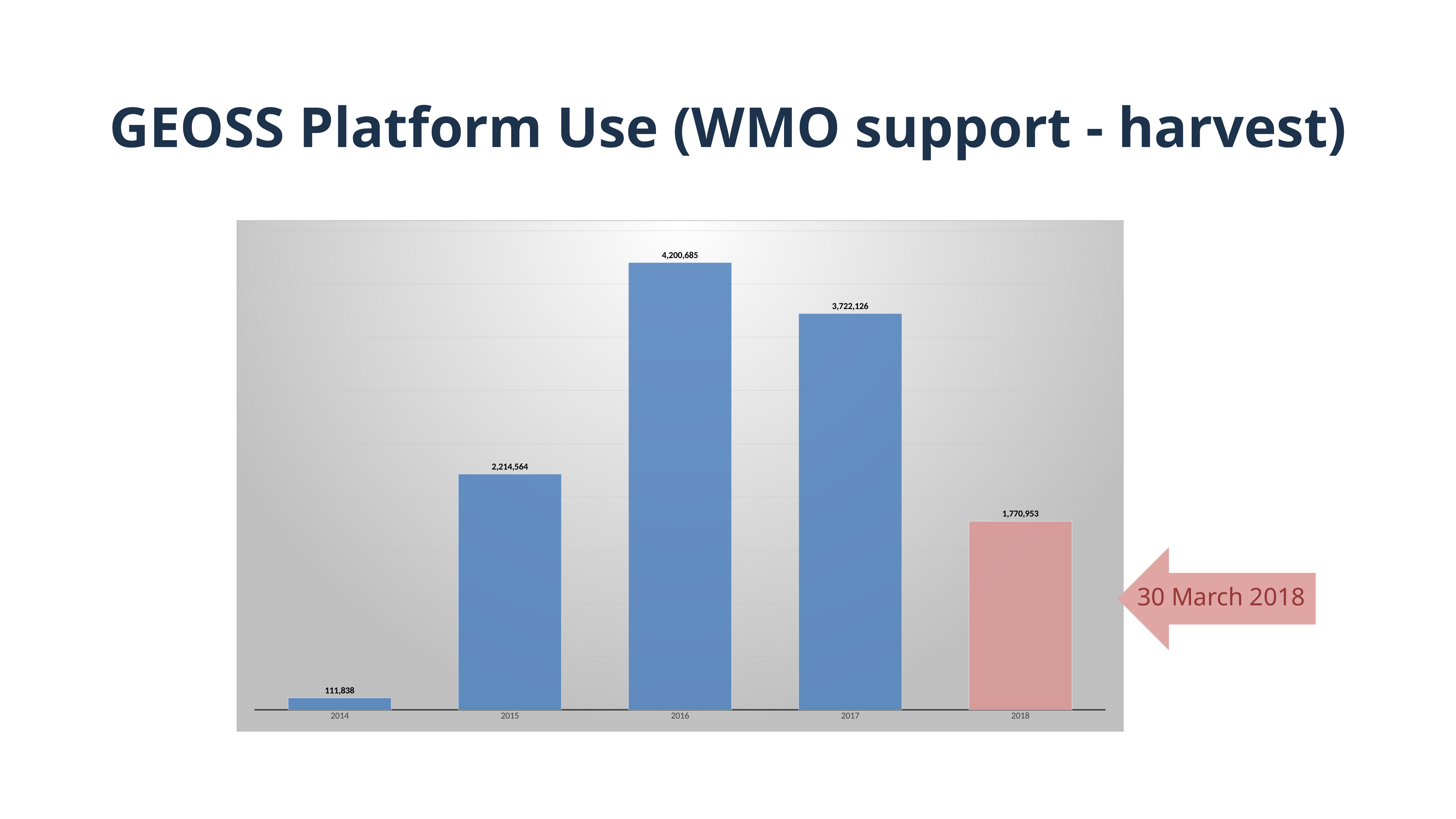
How many years are shown on the x axis? 5 What is the value for 2014? 111,838 Which year has the highest value? 2016 What is the difference between the values for 2015 and 2014? 2,102,726 What kind of chart is shown on the slide? Bar chart Which year has the lowest value? 2014 Which is larger, the value for 2017 or the value for 2018? 2017 What is the value for 2016? 4,200,685 What date does the arrow next to the 2018 bar point to? 30 March 2018 What is the value for 2015? 2,214,564 What is the difference between the values for 2016 and 2017? 478,559 What is the value for 2018? 1,770,953